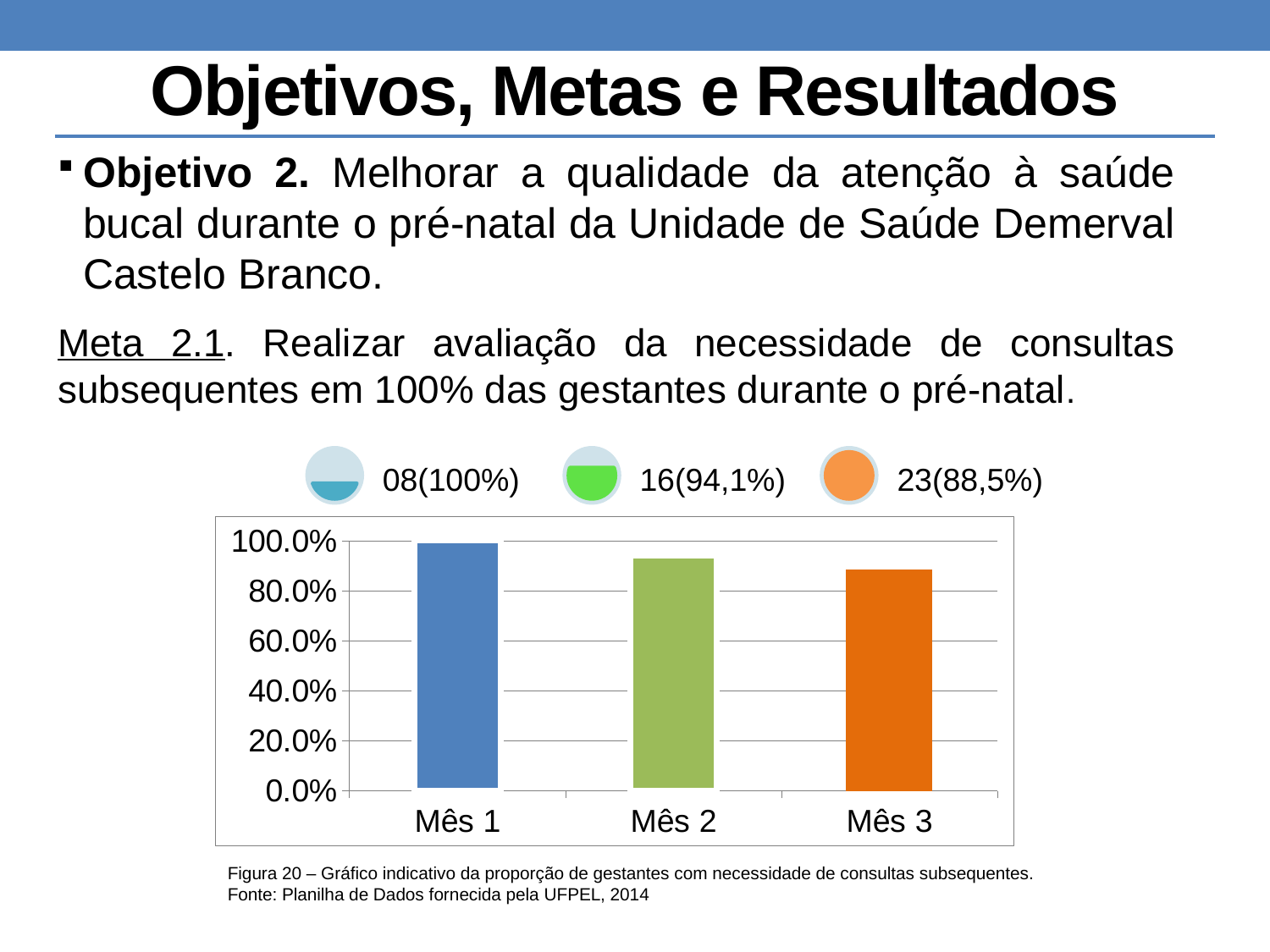
Is the value for Mês 3 greater or less than 100.0%? less What type of chart is shown on the slide? bar chart Is the value for Mês 2 greater or less than 80.0%? greater What percentage is shown for the orange series (Mês 3) in the labels above the chart? 88,5% Which month has the highest value in the chart? Mês 1 Which is larger, the value for Mês 2 or the value for Mês 3? Mês 2 What is the figure number given in the caption below the chart? Figura 20 Do the values rise or fall from Mês 1 to Mês 3? fall What percentage is shown for the green series (Mês 2) in the labels above the chart? 94,1% How many bars (categories) does the chart show? 3 Which month has the lowest value in the chart? Mês 3 What percentage is shown for the blue series (Mês 1) in the labels above the chart? 100%